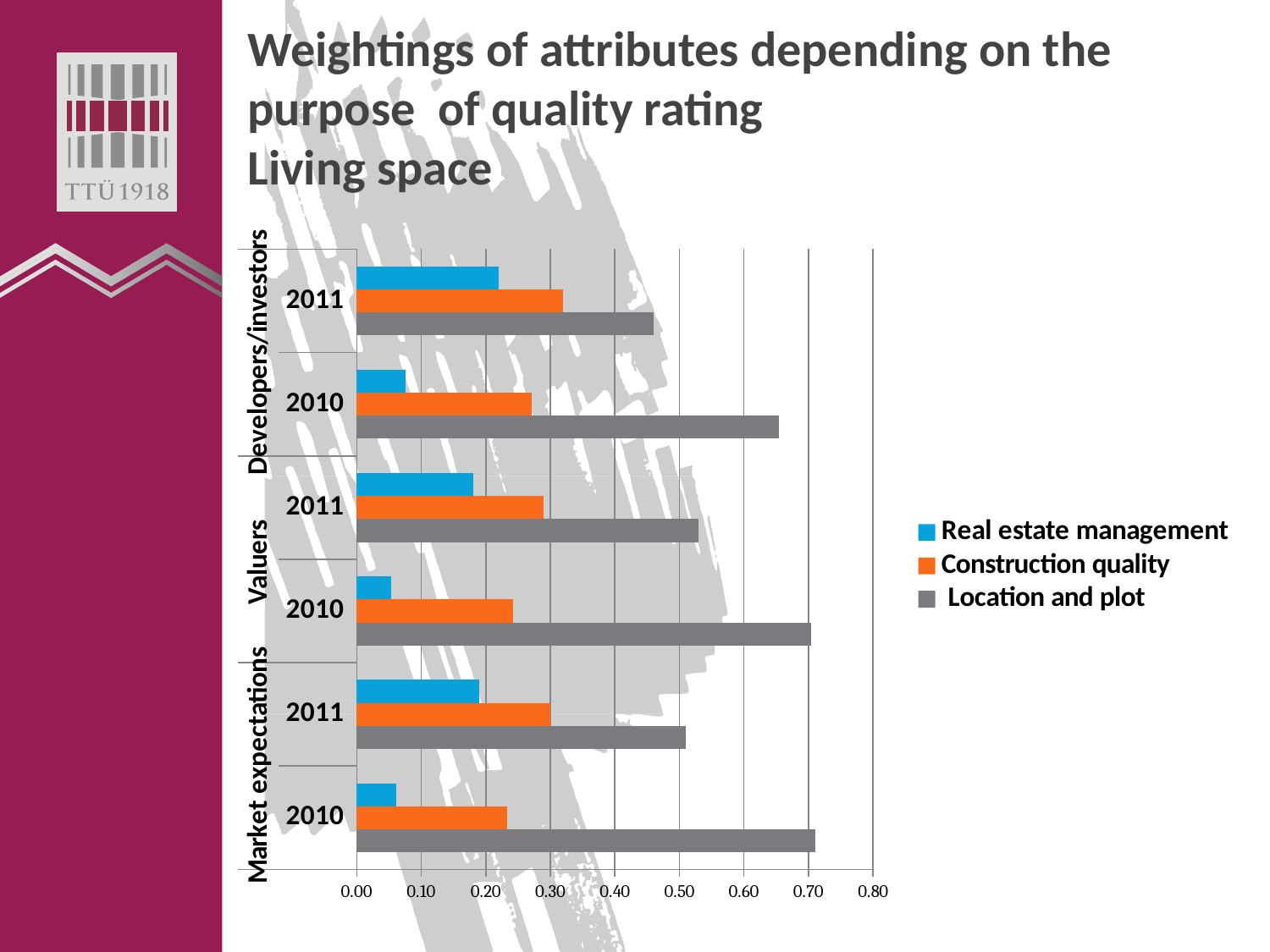
Is the Location and plot value for Valuers 2010 greater or less than 0.60? greater What kind of chart is shown on the slide? bar chart Which series has the shortest bar in every group on the chart? Real estate management Which is larger: the Location and plot value for Developers/investors 2010 or for Developers/investors 2011? Developers/investors 2010 Is the Real estate management value for Developers/investors 2010 greater or less than 0.10? less Is the Location and plot value for Developers/investors 2011 greater or less than 0.50? less What colour are the Construction quality bars? orange Which series has the longest bar in every group on the chart? Location and plot How many bar groups (year categories) are plotted on the chart? 6 Which is larger for Valuers 2011: the Construction quality value or the Real estate management value? Construction quality How many series does the legend list? 3